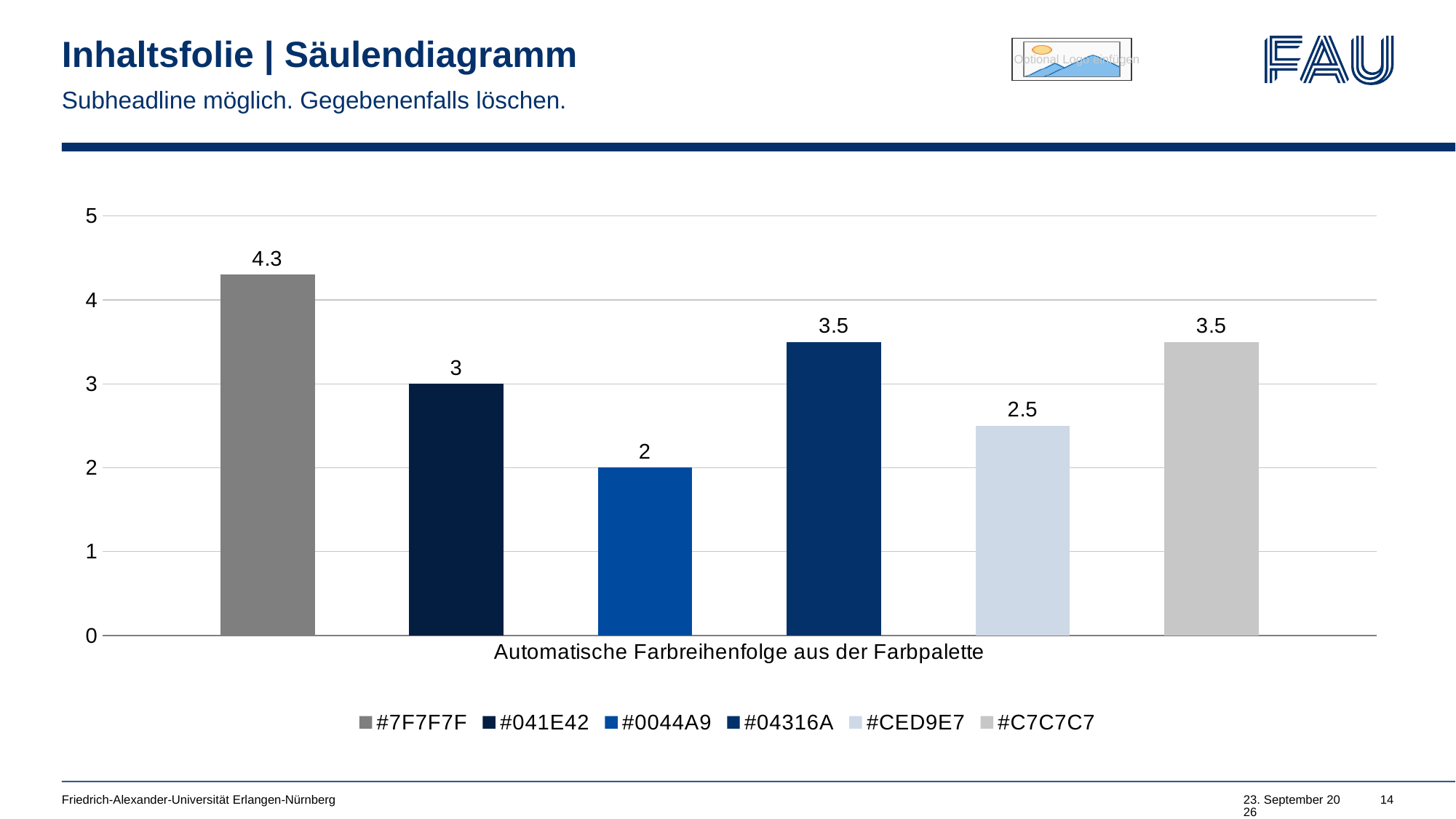
What kind of chart is shown on the slide? bar chart Which series has the highest value? #7F7F7F What is the value of the #7F7F7F series? 4.3 What is the category label shown on the x axis? Automatische Farbreihenfolge aus der Farbpalette How many series does the legend list? 6 Which is larger, the value of the #04316A series or the #CED9E7 series? #04316A Is the value of the #C7C7C7 series greater or less than 3? greater Which series has the lowest value? #0044A9 What is the value of the #041E42 series? 3 What is the value of the #CED9E7 series? 2.5 What is the difference between the values of the #7F7F7F series and the #041E42 series? 1.3 What is the value of the #0044A9 series? 2